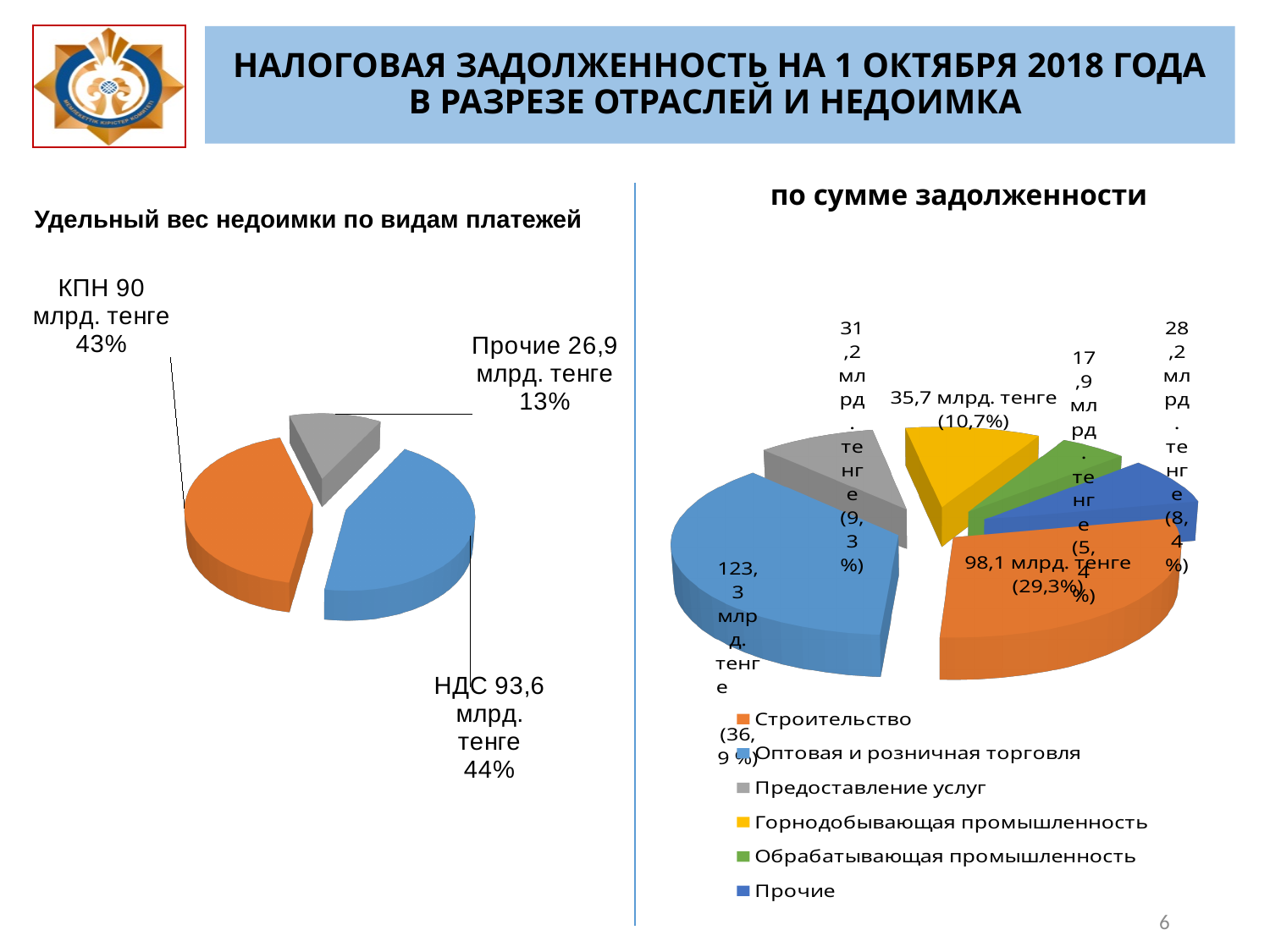
On the right chart 'по сумме задолженности', which category has the smallest share? Обрабатывающая промышленность On the right chart 'по сумме задолженности', how many categories does the legend list? 6 On the left chart 'Удельный вес недоимки по видам платежей', what is the value for КПН? 90 млрд. тенге On the right chart 'по сумме задолженности', which category has the largest share? Оптовая и розничная торговля On the left chart 'Удельный вес недоимки по видам платежей', which category has the smallest share? Прочие On the left chart 'Удельный вес недоимки по видам платежей', what share does НДС have? 44% On the left chart 'Удельный вес недоимки по видам платежей', what is the difference in млрд. тенге between НДС and КПН? 3,6 млрд. тенге On the right chart 'по сумме задолженности', what is the value for Оптовая и розничная торговля? 123,3 млрд. тенге On the left chart 'Удельный вес недоимки по видам платежей', how many slices does the pie have? 3 On the right chart 'по сумме задолженности', which is larger: Горнодобывающая промышленность or Прочие? Горнодобывающая промышленность What kind of chart is the right chart 'по сумме задолженности'? Pie chart On the right chart 'по сумме задолженности', what share does Строительство have? 29,3%